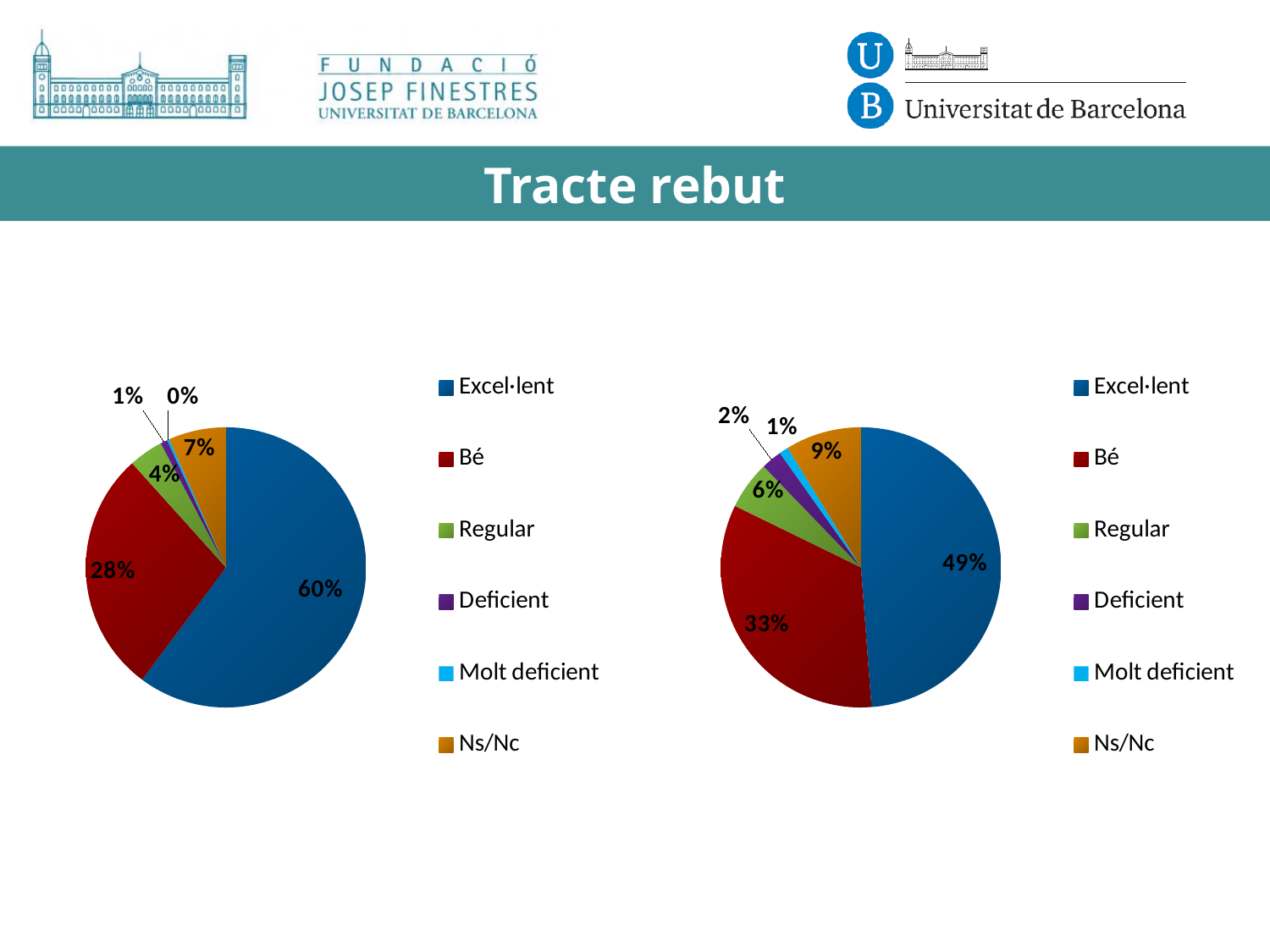
In the left pie chart, which category has the largest slice? Excel·lent In the right pie chart, what share does Bé have? 33% In the left pie chart, what is the value for Ns/Nc? 7% What type of chart is shown on the left of the slide? Pie chart How many categories does the legend of the right pie chart list? 6 In the right pie chart, what is the value for Regular? 6% In the left pie chart, which is larger, Regular or Ns/Nc? Ns/Nc What is the title of the slide containing the two pie charts? Tracte rebut In the left pie chart, which category has the smallest slice? Molt deficient In the right pie chart, what is the difference between Excel·lent and Bé? 16% In the right pie chart, which category has the largest slice? Excel·lent In the left pie chart, what share does Excel·lent have? 60%